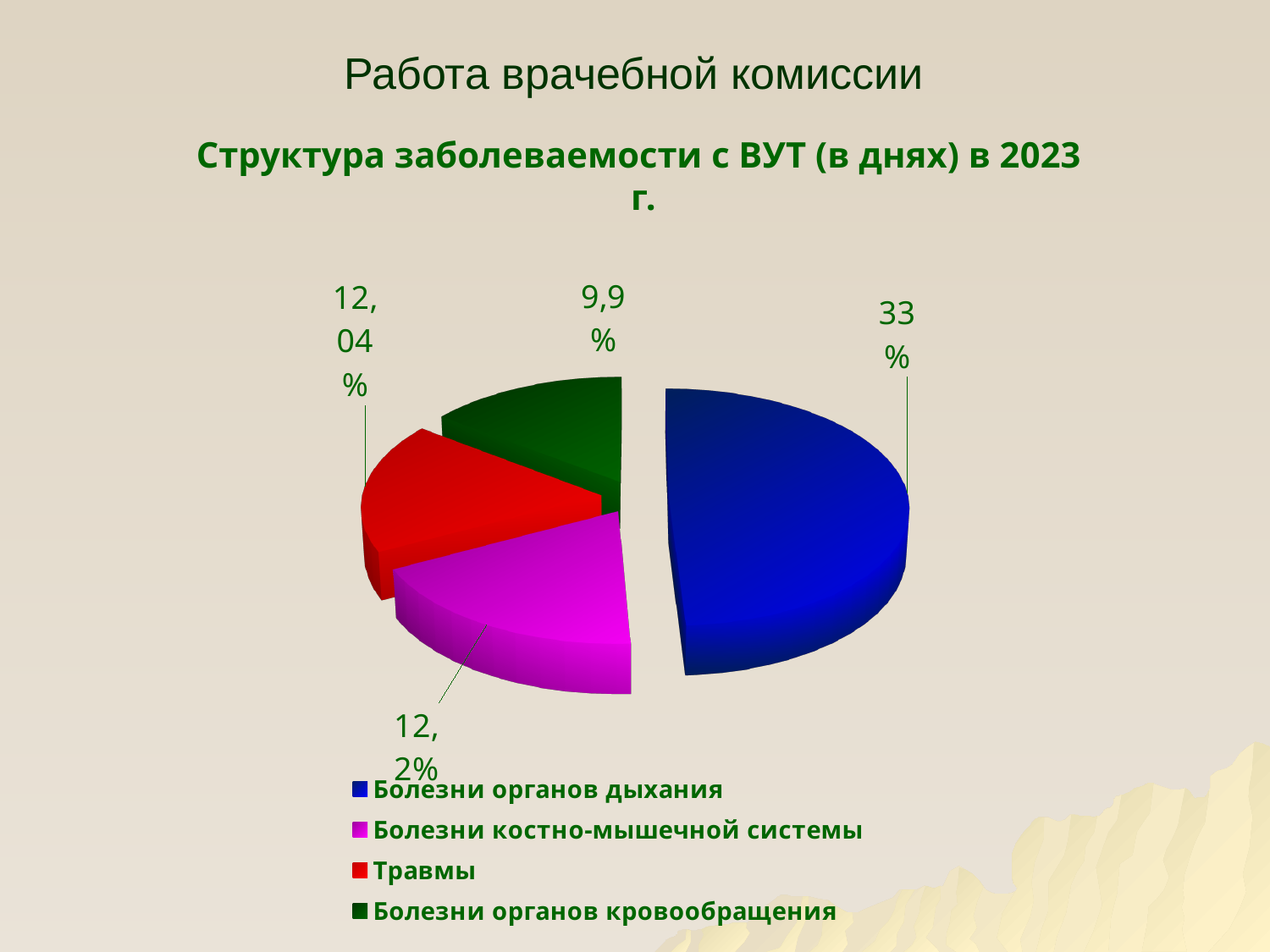
What kind of chart is shown on the slide? Pie chart What is the title of the chart? Структура заболеваемости с ВУТ (в днях) в 2023 г. How many categories does the pie chart show? 4 What percentage is shown for Травмы? 12,04% Which is larger: the slice for Болезни органов дыхания or the slice for Травмы? Болезни органов дыхания Which category has the largest slice of the pie? Болезни органов дыхания What colour is the slice for Травмы? Red What is the difference in percentage points between Болезни органов дыхания and Болезни органов кровообращения? 23,1 What percentage is shown for Болезни органов кровообращения? 9,9% Which category has the smallest slice of the pie? Болезни органов кровообращения What percentage is shown for Болезни костно-мышечной системы? 12,2% What percentage is shown for Болезни органов дыхания? 33%